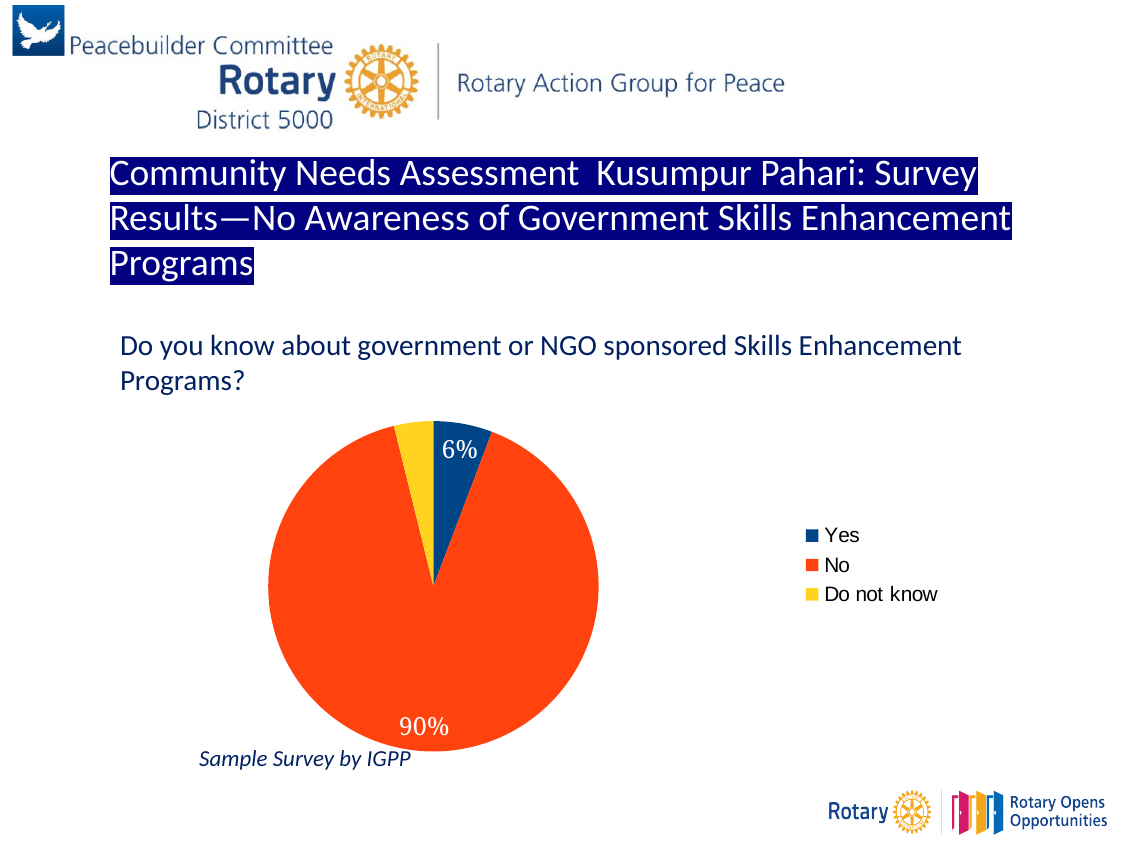
What percentage of respondents answered "No"? 90% Which response has the largest share of the pie? No Which is larger, the share for "Yes" or the share for "No"? No Which response has the smallest share of the pie? Do not know How many response categories does the legend list? 3 What is the difference in percentage points between the "No" share and the "Yes" share? 84 What colour represents "No" in the pie chart? orange-red Which is larger, the share for "Yes" or the share for "Do not know"? Yes What type of chart is shown on the slide? pie chart What survey question does the pie chart present results for? Do you know about government or NGO sponsored Skills Enhancement Programs? What percentage of respondents answered "Yes"? 6%